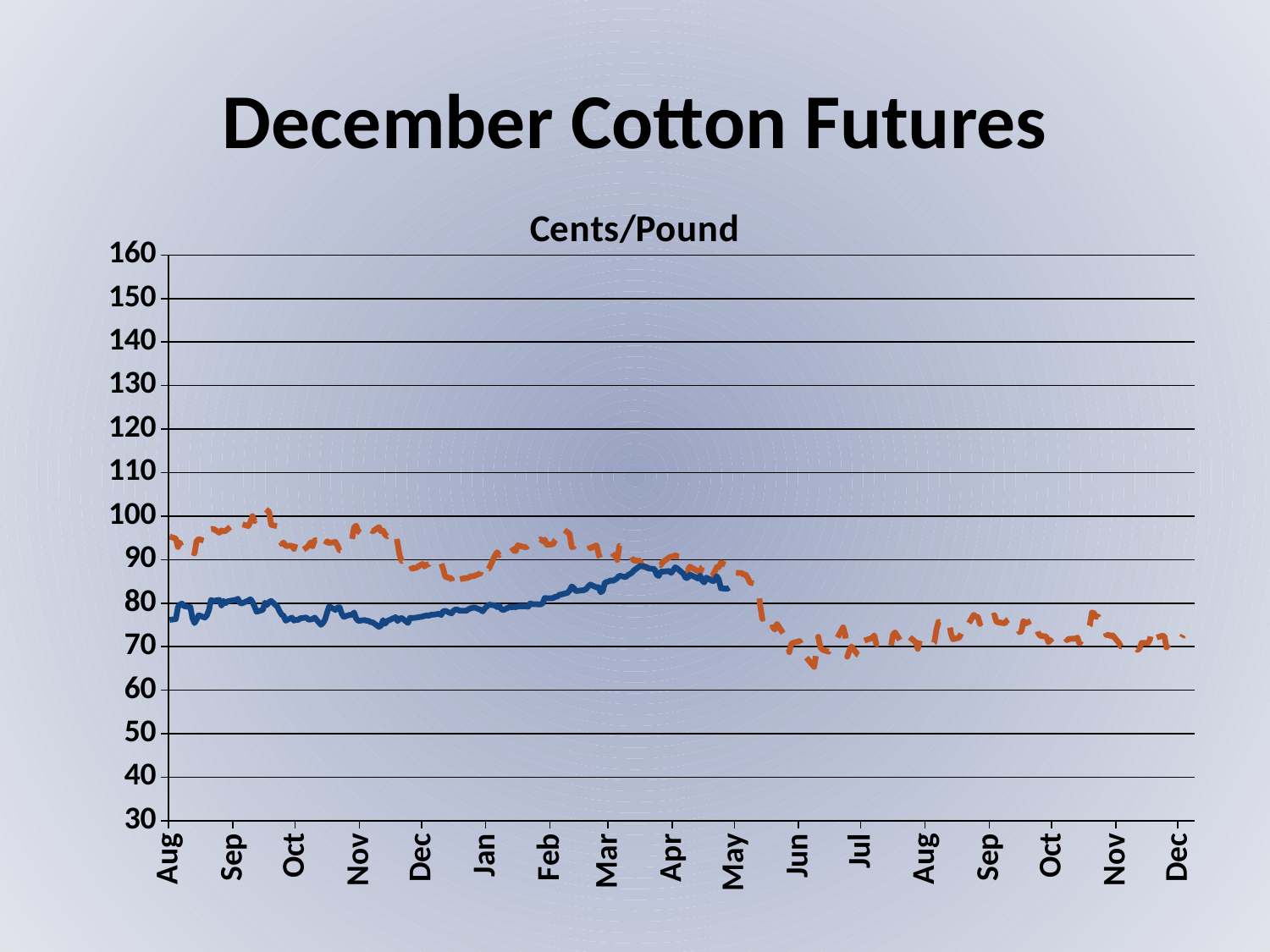
Is the value of the dashed orange line at the first Sep greater or less than 90? greater Is the value of the dashed orange line at the second Nov greater or less than 80? less Is the value of the solid blue line at Aug greater or less than 80? less At Aug, which line is higher, the solid blue line or the dashed orange line? dashed orange line Does the solid blue line rise or fall from Nov to Mar? rise What kind of chart is shown on the slide? line chart What is the title of the chart? Cents/Pound How many lines are plotted on the chart? 2 How many month labels are shown along the x axis? 17 Does the dashed orange line rise or fall from May to Jun? fall